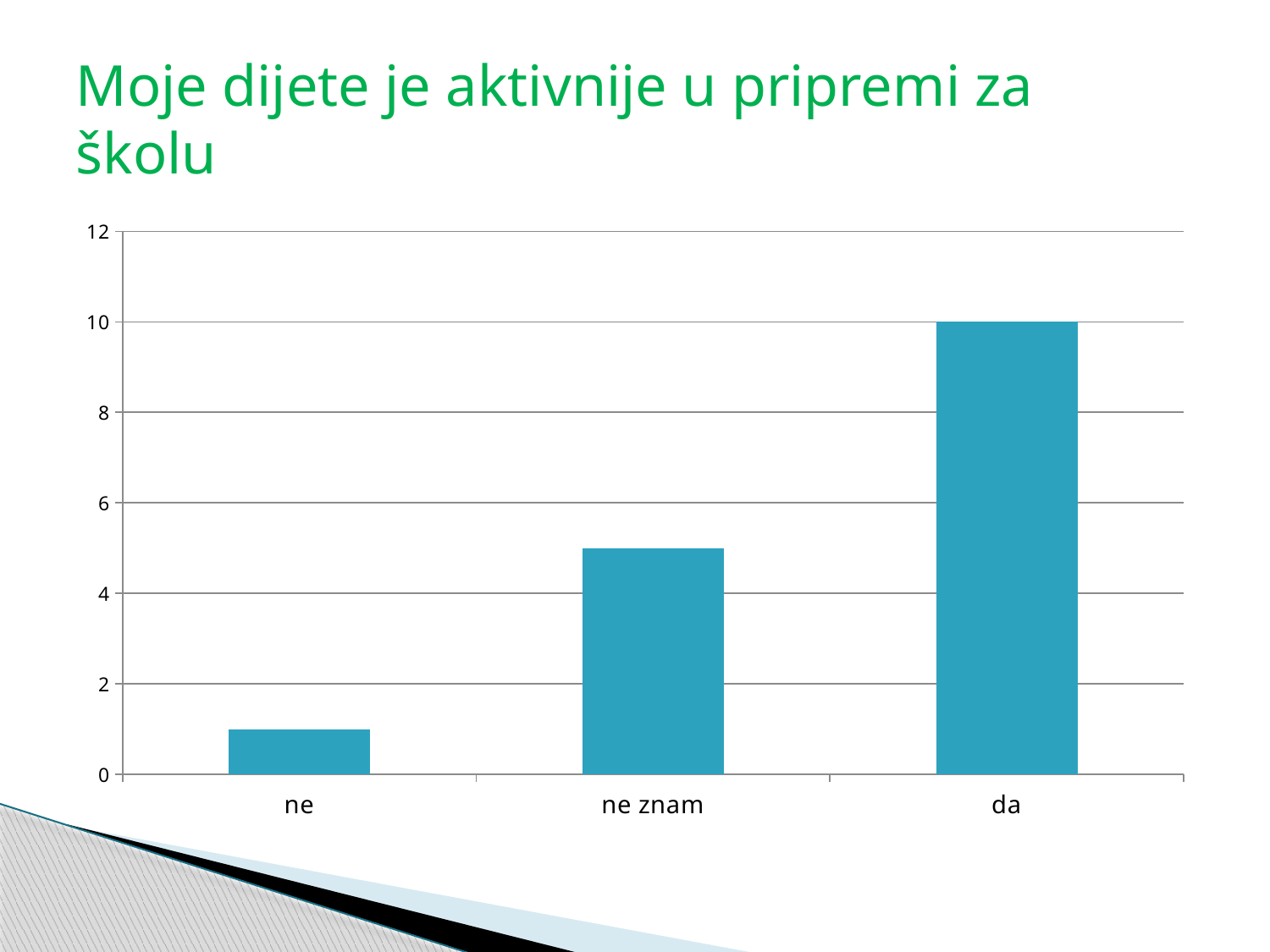
Which category has the lowest bar? ne Is the value for "ne znam" greater or less than 4? greater Which category has the highest bar? da Which is larger, the value for "ne znam" or the value for "da"? da Do the values rise or fall from left to right along the x axis? rise Which is larger, the value for "ne" or the value for "ne znam"? ne znam What kind of chart is shown on the slide? bar chart What is the value of the bar for "da"? 10 What is the title of the slide above the chart? Moje dijete je aktivnije u pripremi za školu Is the value for "ne" greater or less than 2? less Is the value for "ne znam" greater or less than 6? less How many categories are shown on the x axis? 3